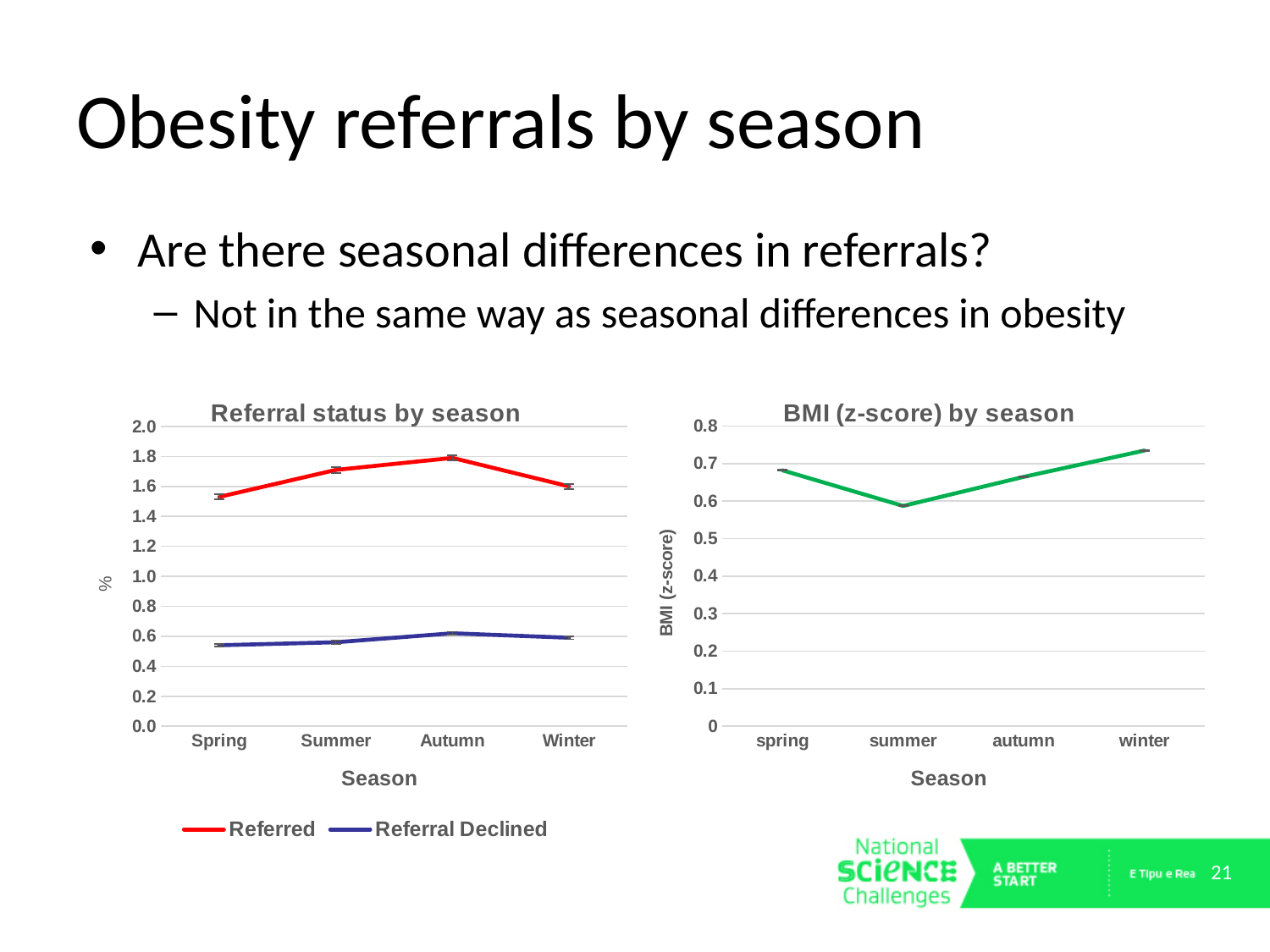
In the 'BMI (z-score) by season' chart, is the value for winter greater or less than 0.7? greater How many series does the legend of the 'Referral status by season' chart list? 2 How many seasons are plotted on the x axis of the 'BMI (z-score) by season' chart? 4 What type of chart is the 'Referral status by season' chart? line chart In the 'Referral status by season' chart, which season has the highest value for Referred? Autumn In the 'BMI (z-score) by season' chart, which season has the highest BMI z-score? winter In the 'Referral status by season' chart, which is larger in Winter: Referred or Referral Declined? Referred In the 'Referral status by season' chart, is the Referral Declined value for Spring greater or less than 0.6? less In the 'BMI (z-score) by season' chart, which season has the lowest BMI z-score? summer In the 'Referral status by season' chart, is the Referred value for Spring greater or less than 1.4? greater In the 'Referral status by season' chart, which season has the lowest value for Referred? Spring In the 'Referral status by season' chart, which series is drawn in red? Referred